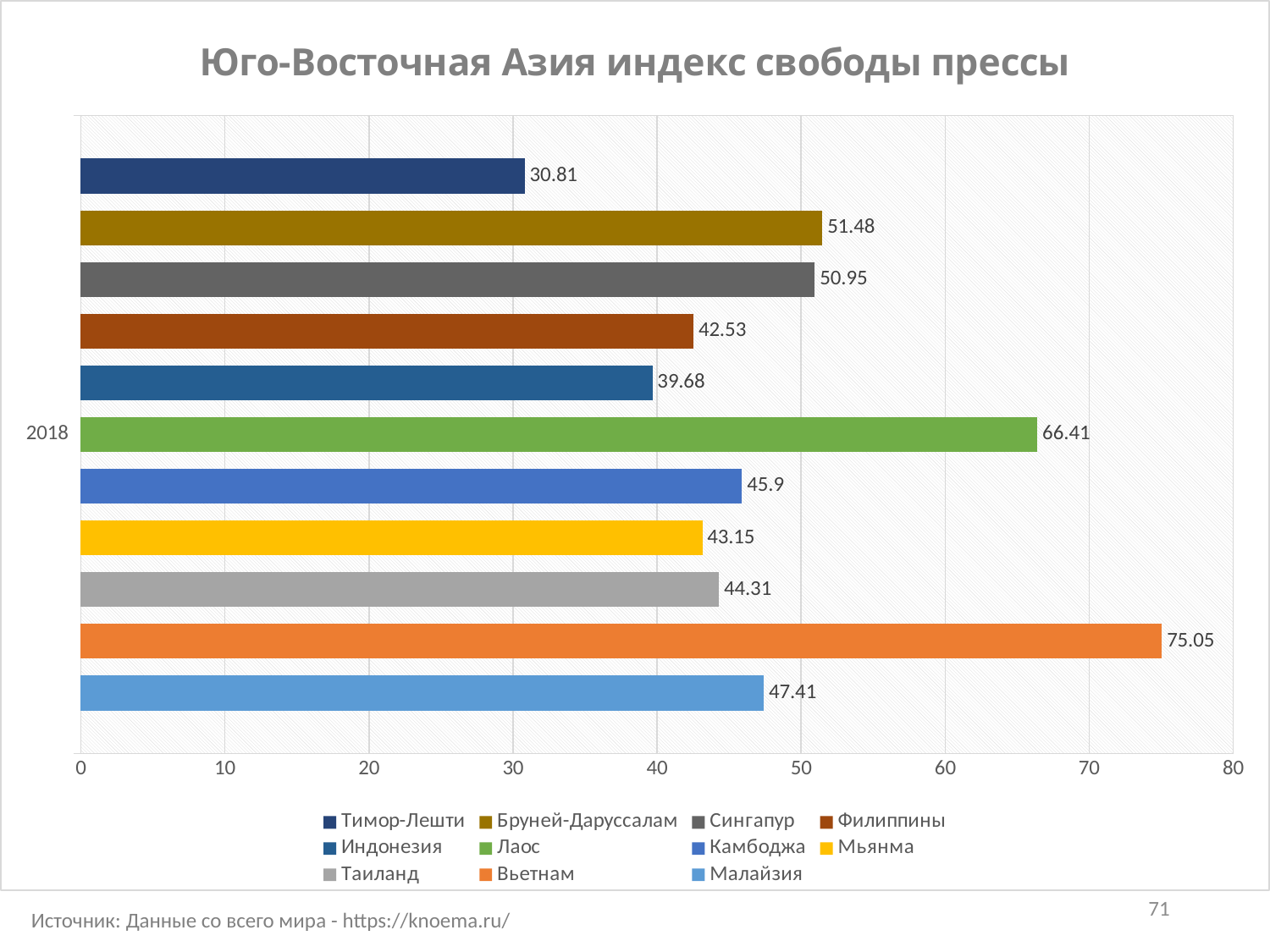
What year is labelled on the vertical axis of the chart? 2018 Is the value for Малайзия greater or less than 50? less What type of chart is shown on the slide? Bar chart What is the value shown for Тимор-Лешти? 30.81 What is the value shown for Мьянма? 43.15 What is the value shown for Лаос? 66.41 What is the press freedom index value for Вьетнам? 75.05 Which has a larger value, Индонезия or Камбоджа? Камбоджа Which country has the lowest value on the chart? Тимор-Лешти What is the difference between the values for Вьетнам and Лаос? 8.64 How many countries are listed in the legend? 11 Which country has the highest value on the chart? Вьетнам